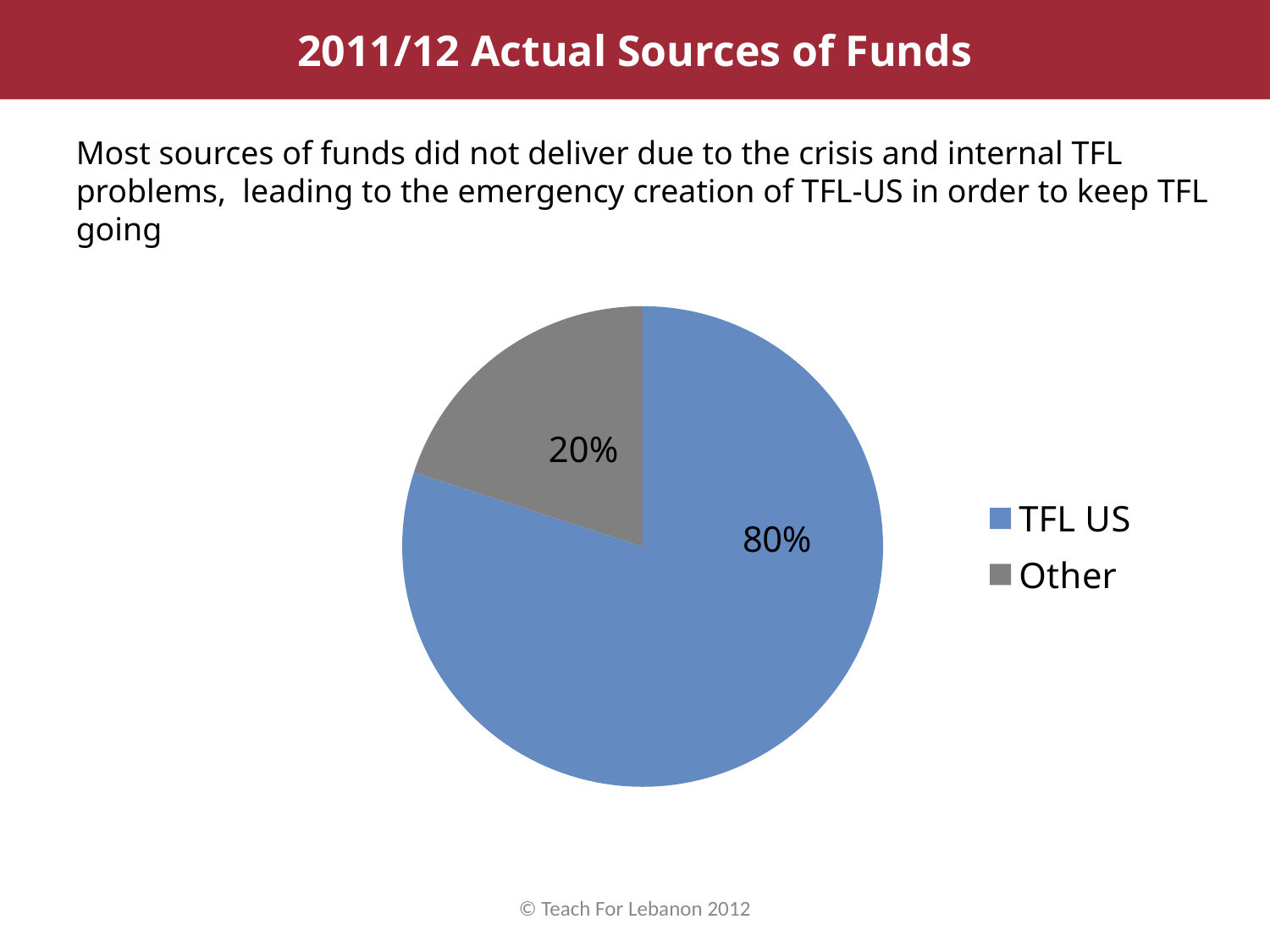
What share of the pie does TFL US account for? 80% Which is larger, the TFL US slice or the Other slice? TFL US What is the total of the two slices shown in the pie chart? 100% What is the difference in percentage points between the TFL US slice and the Other slice? 60 percentage points How many entries does the legend list? 2 What share of the pie does Other account for? 20% What is the title of the slide containing the pie chart? 2011/12 Actual Sources of Funds What kind of chart is shown on the slide? pie chart How many slices does the pie chart have? 2 What colour is the TFL US slice in the pie chart? blue Which slice of the pie is the largest? TFL US Which slice of the pie is the smallest? Other